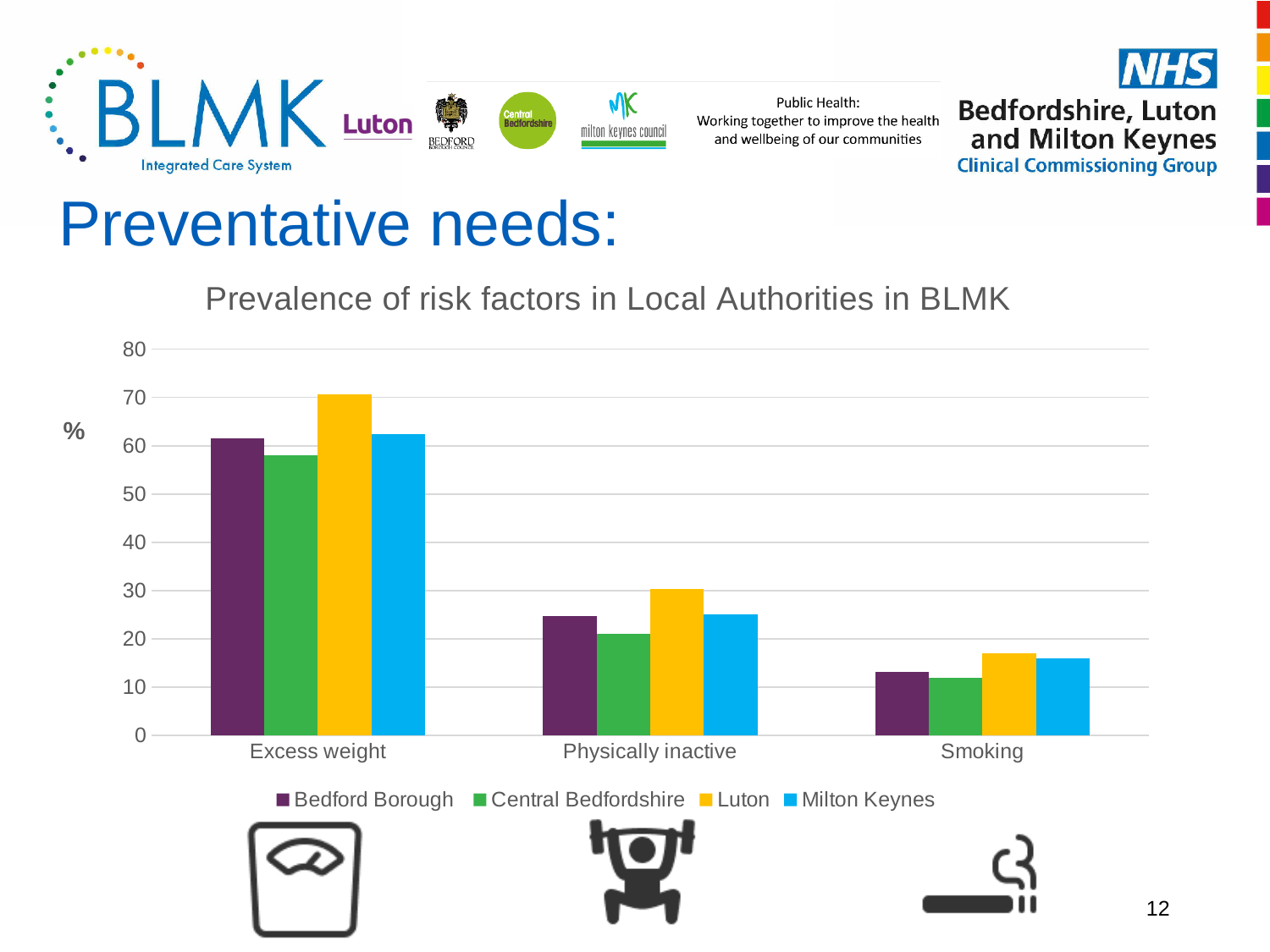
Which local authority has the lowest value for Excess weight? Central Bedfordshire Which local authority has the highest value for Excess weight? Luton What kind of chart is shown on the slide? bar chart Is the value for Luton in Smoking greater or less than 20? less Is the value for Central Bedfordshire in Excess weight greater or less than 60? less How many risk factor categories are shown on the x axis? 3 Which local authority has the highest value for Physically inactive? Luton Which local authority has the lowest value for Physically inactive? Central Bedfordshire Do the values rise or fall moving from Excess weight to Smoking along the x axis? fall What is the title of the chart? Prevalence of risk factors in Local Authorities in BLMK How many series does the legend list? 4 Which is larger for Physically inactive: Luton or Central Bedfordshire? Luton